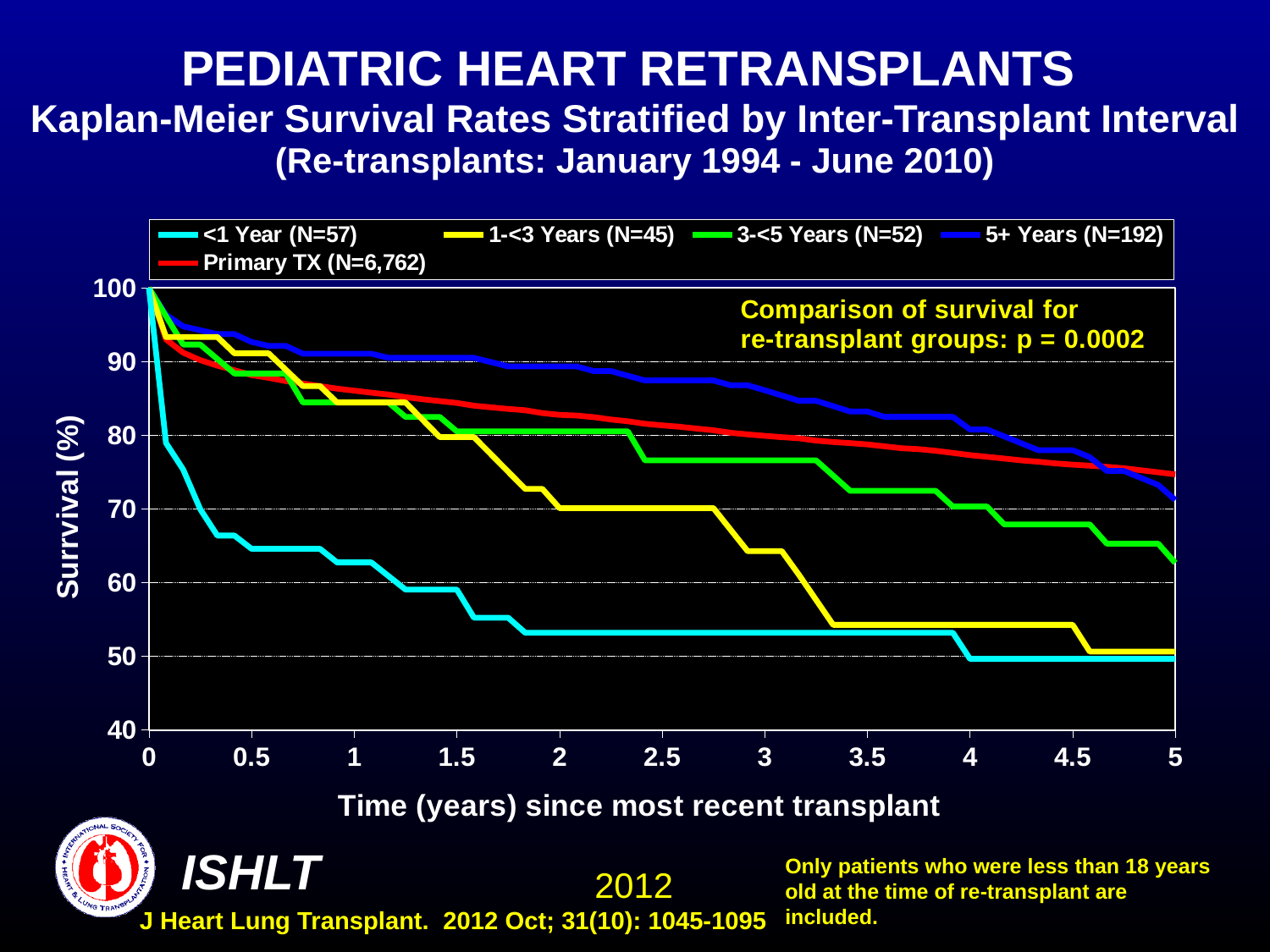
What is the p-value shown for the comparison of survival for re-transplant groups? p = 0.0002 How many series does the legend list? 5 Is the survival value for the Primary TX group at 5 years greater or less than 70? greater Do the survival curves rise or fall as time since most recent transplant increases? fall Which group has the highest survival at 2 years? 5+ Years Is the survival value for the 3-<5 Years group at 5 years greater or less than 60? greater At 1 year, which group has higher survival: <1 Year or 5+ Years? 5+ Years Which group has the lowest survival at 2 years? <1 Year Is the survival value for the 5+ Years group at 3 years greater or less than 80? greater What kind of chart is shown on the slide? line chart At 4 years, which group has higher survival: 3-<5 Years or 1-<3 Years? 3-<5 Years